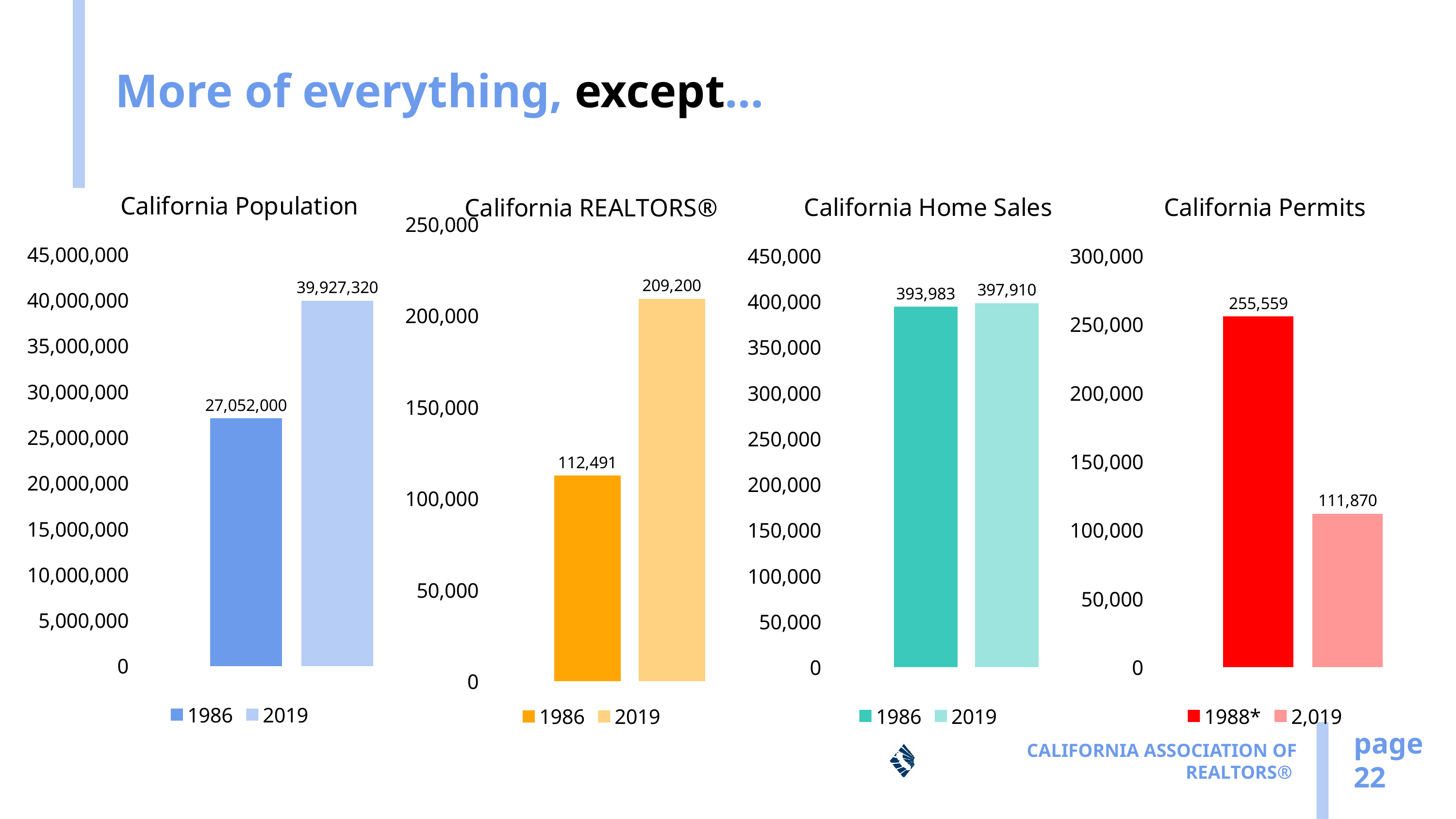
What type of chart is the California Home Sales chart? bar chart In the California Home Sales chart, what is the difference between the 2019 and 1986 values? 3,927 In the California Population chart, what is the value for 1986? 27,052,000 In the California Population chart, what is the value for 2019? 39,927,320 In the California REALTORS® chart, which year has the higher value, 1986 or 2019? 2019 In the California Permits chart, what is the difference between the 1988* and 2,019 values? 143,689 In the California REALTORS® chart, what is the difference between the 2019 and 1986 values? 96,709 In the California Permits chart, which series has the lowest value? 2,019 In the California REALTORS® chart, what is the value for 1986? 112,491 In the California Home Sales chart, what is the value for 2019? 397,910 In the California Permits chart, what is the value for 1988*? 255,559